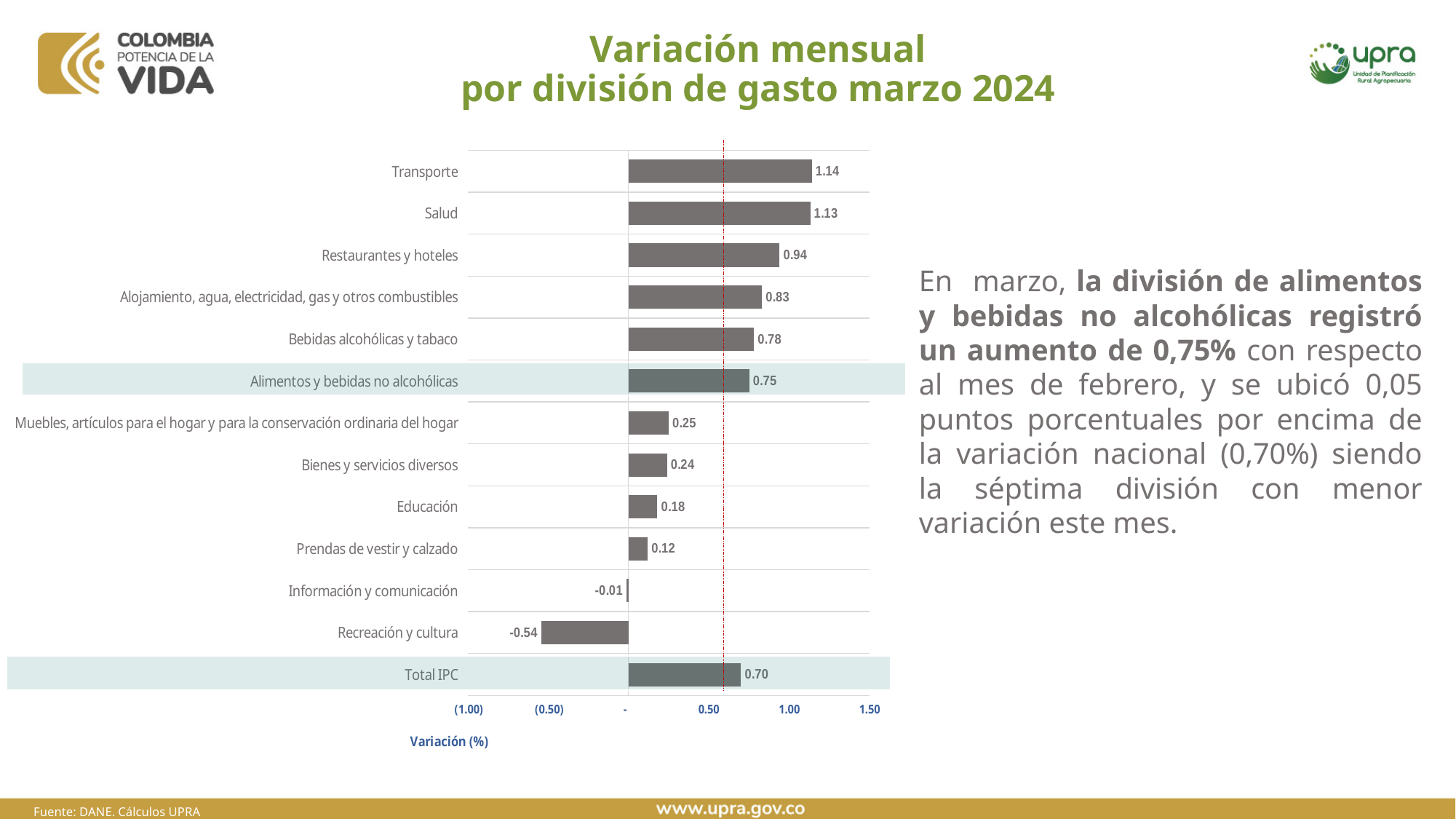
What is the value for Transporte? 1.14 What is the value for Recreación y cultura? -0.54 Which is larger, the value for Educación or the value for Prendas de vestir y calzado? Educación What is the value for Total IPC? 0.70 Which category has the highest value? Transporte Which category has the lowest value? Recreación y cultura Is the value for Restaurantes y hoteles greater or less than 0.50? greater What is the value for Alimentos y bebidas no alcohólicas? 0.75 How many categories (bars) are shown in the chart? 13 What type of chart is shown on the slide? Bar chart What is the difference between the values for Salud and Restaurantes y hoteles? 0.19 What is the difference between the values for Alimentos y bebidas no alcohólicas and Total IPC? 0.05